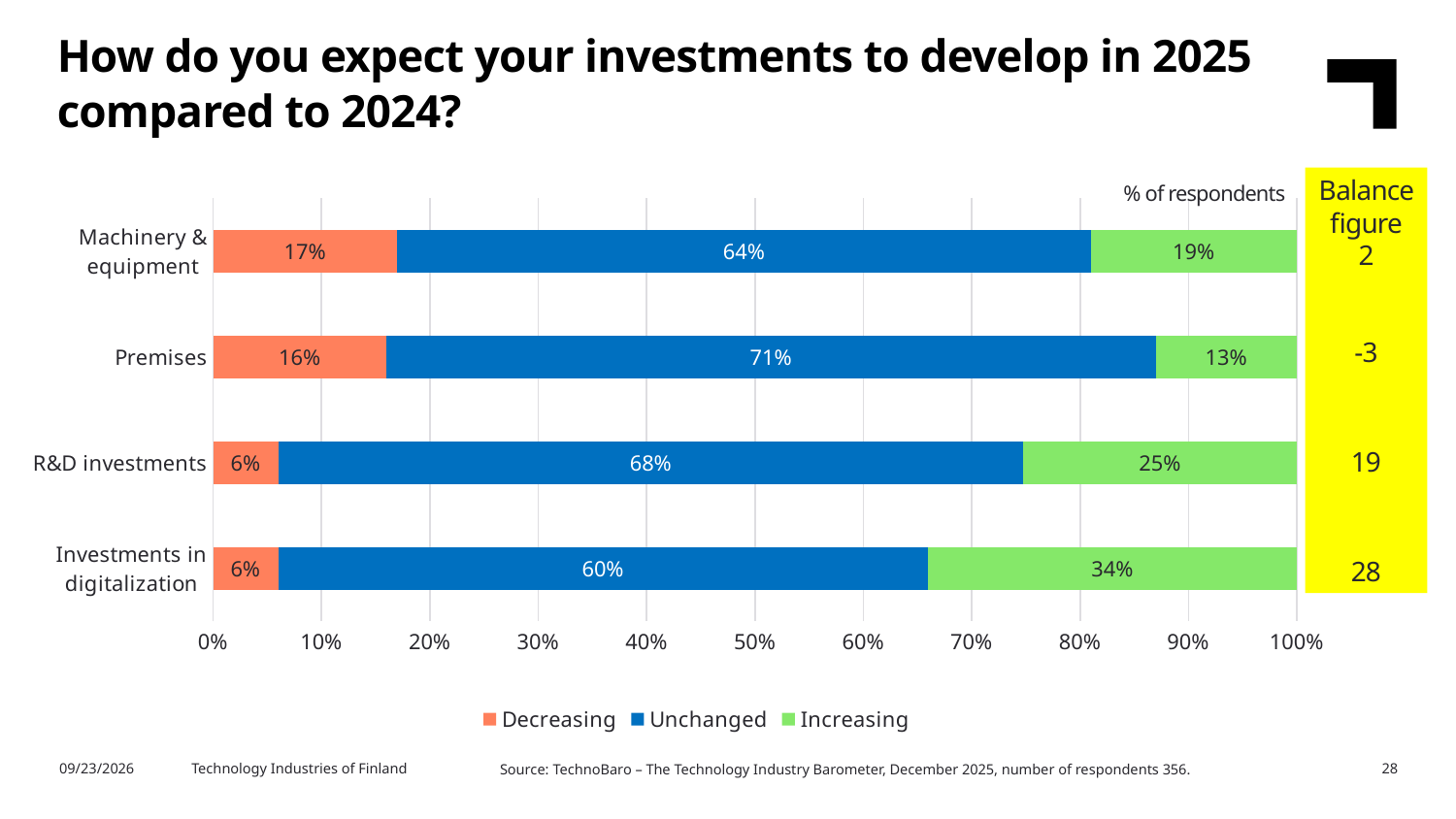
What percentage of respondents expect Investments in digitalization to be Increasing? 34% Which category has the lowest share of respondents expecting Increasing investments? Premises Which colour represents the Decreasing series in the legend? Orange What kind of chart is shown on the slide? Stacked bar chart Which is larger: the Unchanged share for Premises or the Unchanged share for R&D investments? Premises How many series does the legend list? 3 How many categories are shown on the chart? 4 What is the balance figure shown for R&D investments? 19 Which category has the highest share of respondents expecting Increasing investments? Investments in digitalization What percentage of respondents expect Machinery & equipment investments to be Unchanged? 64% What is the difference between the Increasing share for R&D investments and the Increasing share for Premises? 12% What percentage of respondents expect Premises investments to be Decreasing? 16%